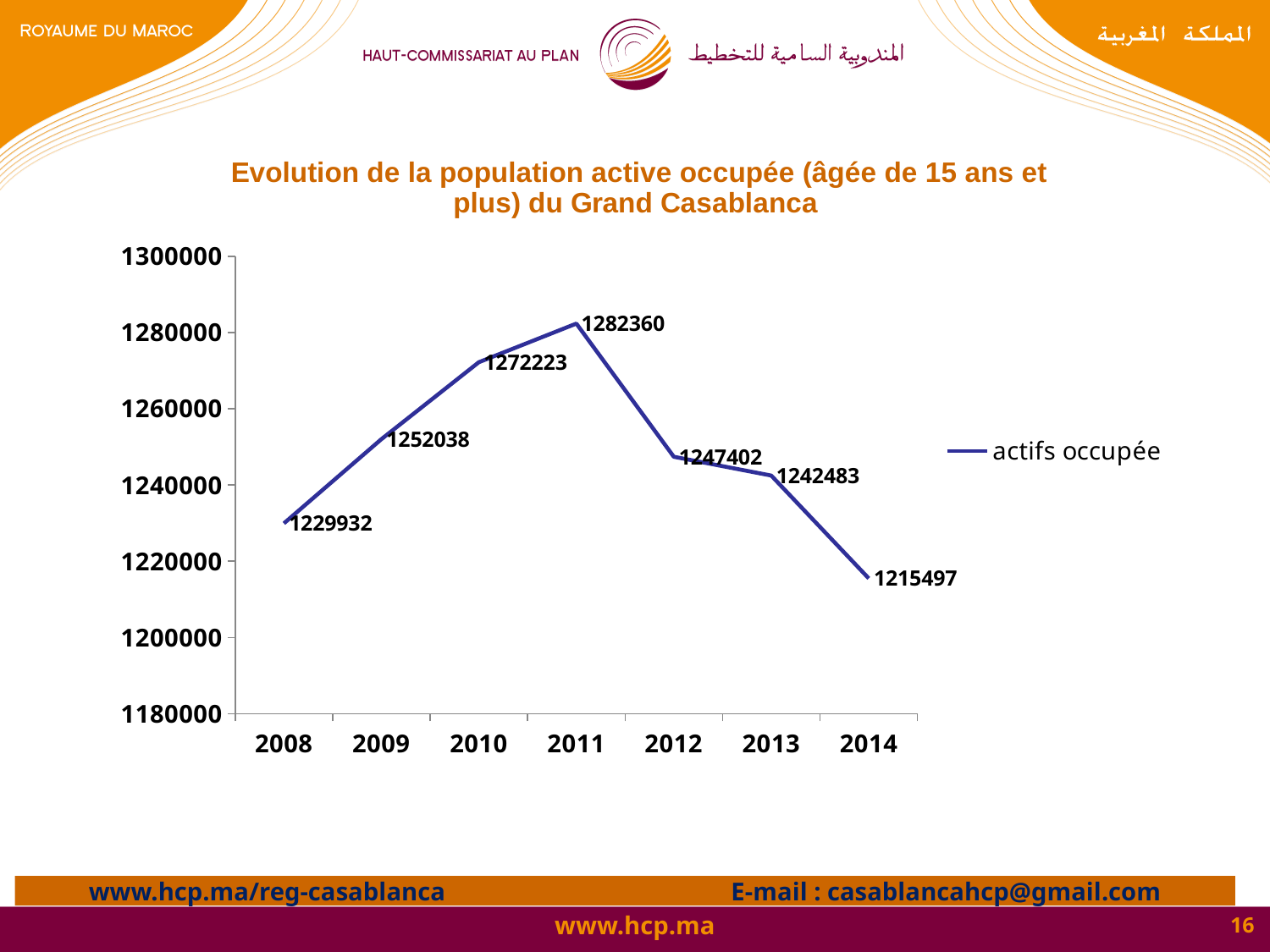
What is the value for 2011? 1282360 How many years are plotted on the x axis? 7 What is the value for 2008? 1229932 Which year has the lowest value? 2014 Which year has the highest value? 2011 What kind of chart is shown? line chart Is the value for 2013 greater or less than 1240000? greater Which is larger, the value for 2010 or the value for 2012? 2010 What is the difference between the values for 2011 and 2014? 66863 What is the value for 2014? 1215497 Do the values rise or fall from 2011 to 2014? fall How many series does the legend list? 1